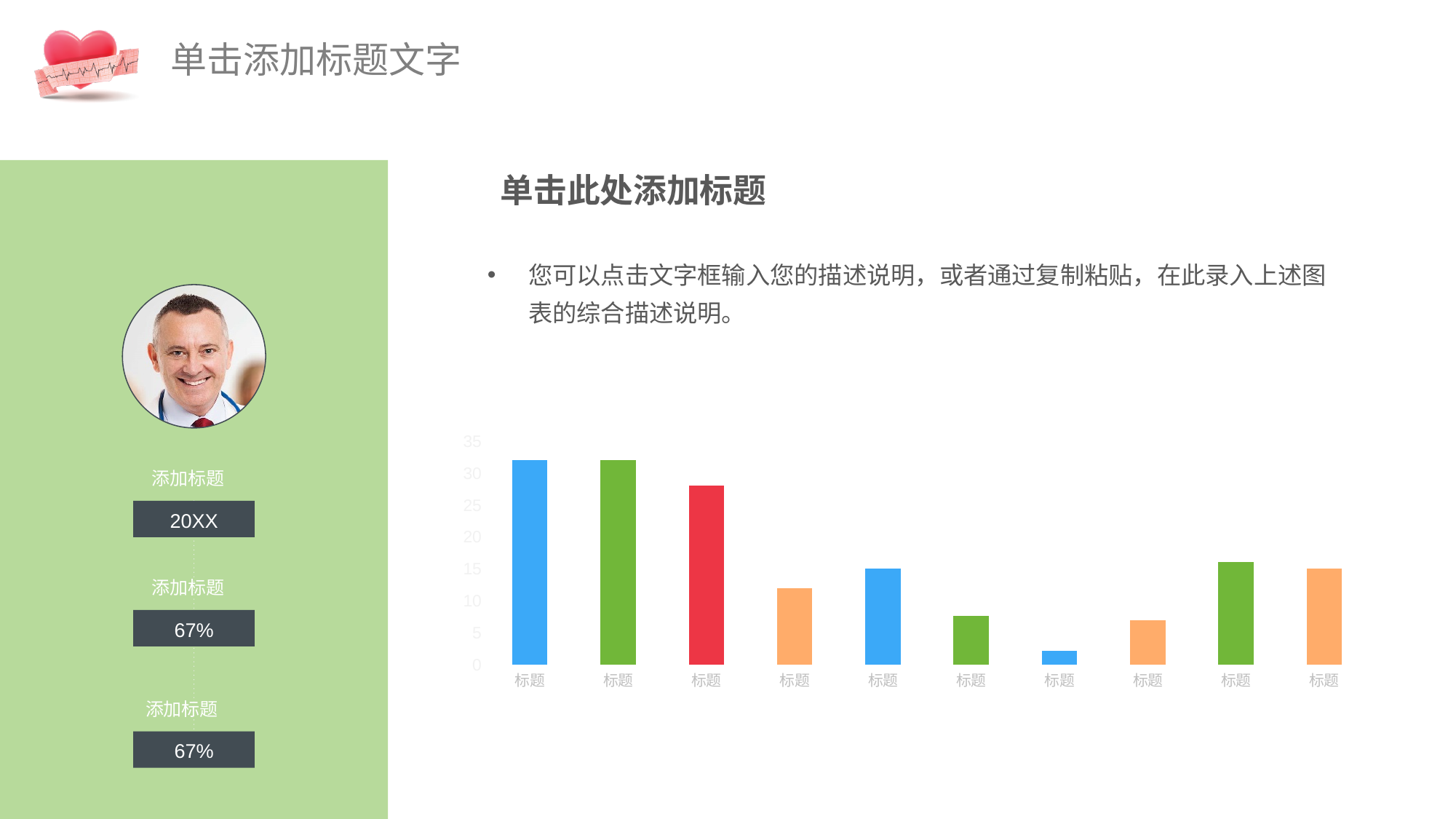
Is the value of the third bar greater or less than 25? greater What label is shown under each bar on the horizontal axis? 标题 Is the value of the fourth bar greater or less than 15? less How many bars are plotted in the chart? 10 Is the value of the seventh bar greater or less than 5? less Which is larger, the third bar or the fourth bar? the third bar What kind of chart is shown on the slide? bar chart Which is larger, the sixth bar or the ninth bar? the ninth bar What is the highest value shown on the vertical axis? 35 Which bar is the lowest in the chart? the seventh bar (blue)